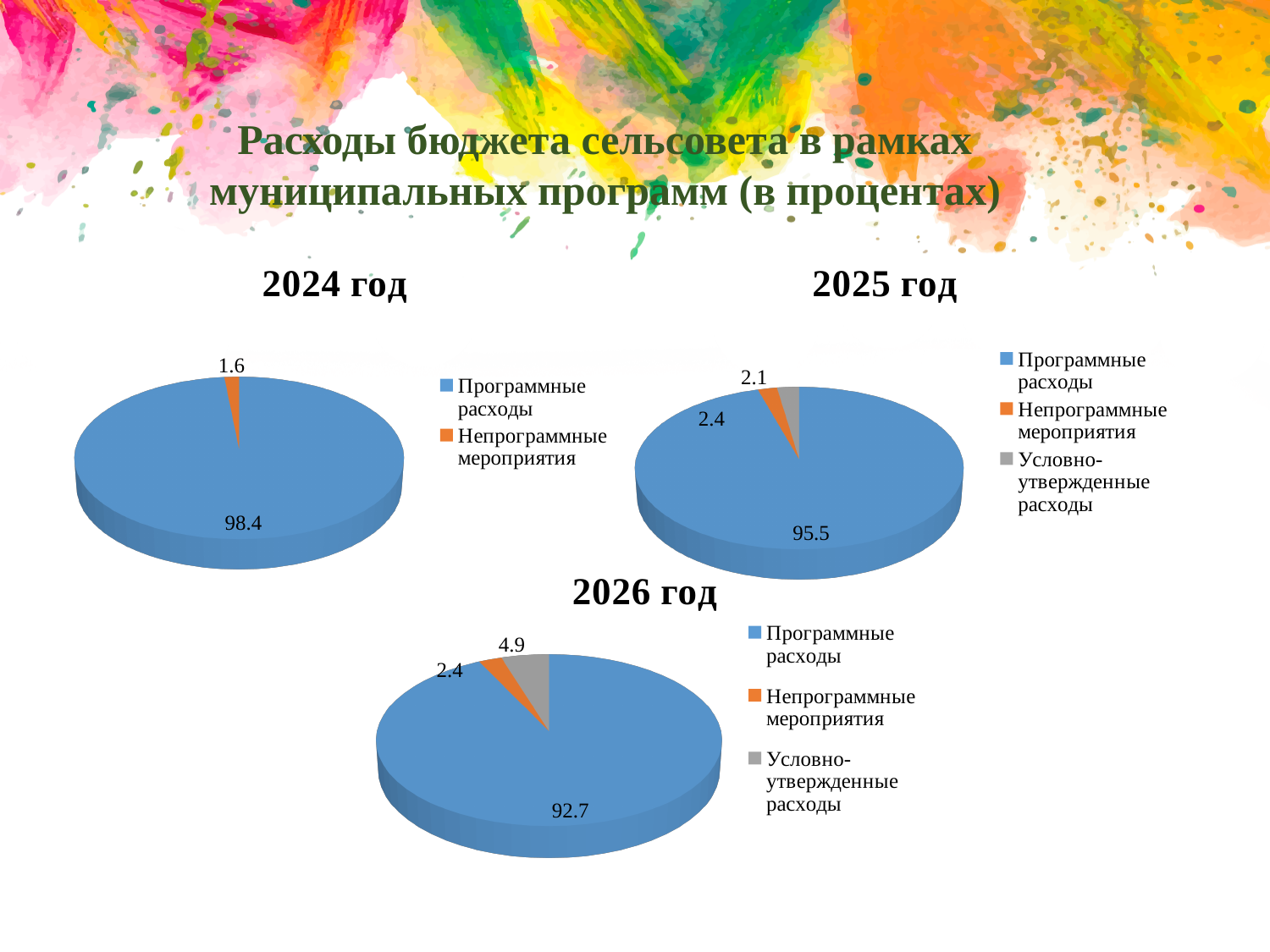
What type of chart is the 2024 год chart? Pie chart In the 2025 год chart, which is larger: Непрограммные мероприятия or Условно-утвержденные расходы? Условно-утвержденные расходы In the 2026 год chart, which category has the smallest slice? Непрограммные мероприятия How many categories does the 2025 год chart show? 3 In the 2024 год chart, what is the value for Программные расходы? 98.4 How many entries does the legend of the 2024 год chart list? 2 In the 2026 год chart, what is the value for Условно-утвержденные расходы? 4.9 In the 2026 год chart, what is the difference between Программные расходы and Условно-утвержденные расходы? 87.8 In the 2024 год chart, what is the value for Непрограммные мероприятия? 1.6 In the 2026 год chart, what is the value for Программные расходы? 92.7 In the 2025 год chart, what is the value for Условно-утвержденные расходы? 2.4 In the 2025 год chart, which category has the largest slice? Программные расходы